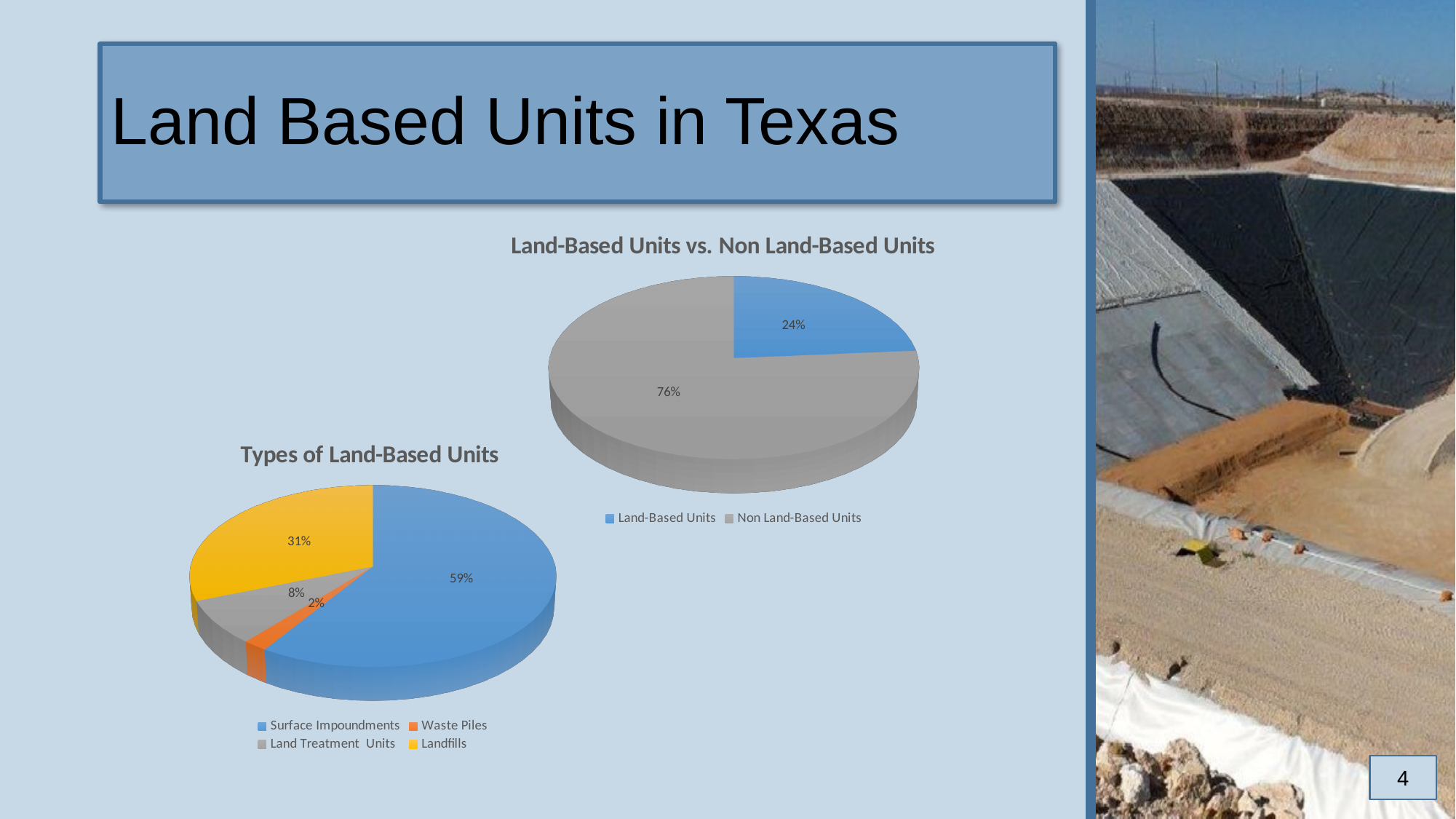
In the 'Types of Land-Based Units' chart, what is the difference between the Surface Impoundments share and the Landfills share? 28% What kind of chart is the 'Land-Based Units vs. Non Land-Based Units' chart? Pie chart In the 'Land-Based Units vs. Non Land-Based Units' chart, what share is Land-Based Units? 24% In the 'Types of Land-Based Units' chart, what share is Landfills? 31% In the 'Types of Land-Based Units' chart, which category has the smallest slice? Waste Piles How many categories does the 'Types of Land-Based Units' chart show? 4 In the 'Types of Land-Based Units' chart, what share is Land Treatment Units? 8% In the 'Types of Land-Based Units' chart, which category has the largest slice? Surface Impoundments In the 'Land-Based Units vs. Non Land-Based Units' chart, which is larger, Land-Based Units or Non Land-Based Units? Non Land-Based Units